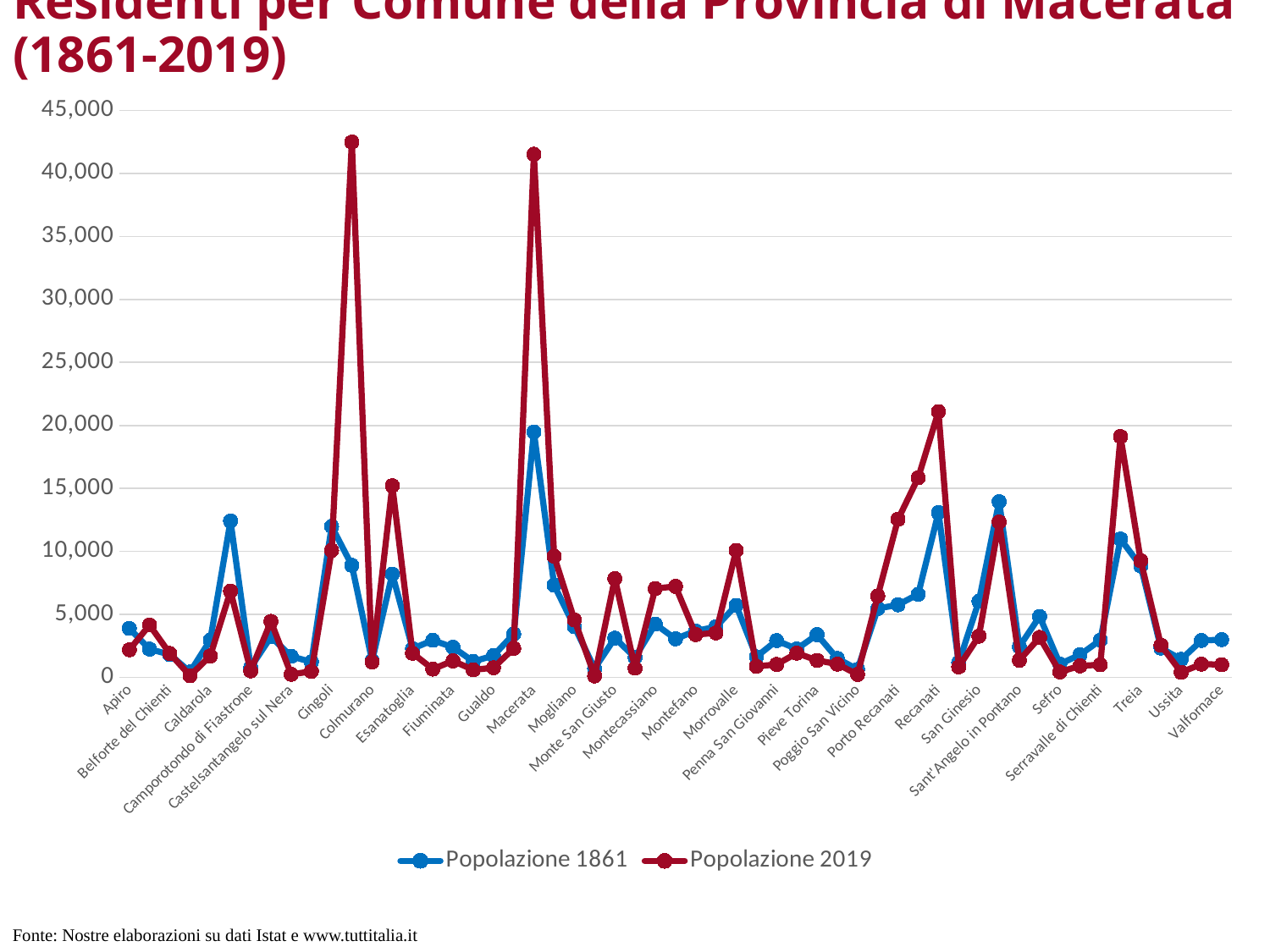
For Cingoli, which is larger: Popolazione 1861 or Popolazione 2019? Popolazione 1861 What kind of chart is shown on the slide? Line chart How many series does the legend list? 2 For Morrovalle, which is larger: Popolazione 1861 or Popolazione 2019? Popolazione 2019 For Monte San Giusto, which is larger: Popolazione 1861 or Popolazione 2019? Popolazione 2019 What are the two series named in the legend? Popolazione 1861 and Popolazione 2019 Is the Popolazione 2019 value for Porto Recanati greater or less than 10,000? greater Which labelled comune has the highest value for Popolazione 1861? Macerata Which colour is used for the Popolazione 2019 series? Red Is the Popolazione 1861 value for Cingoli greater or less than 10,000? greater Is the Popolazione 2019 value for Macerata greater or less than 40,000? greater